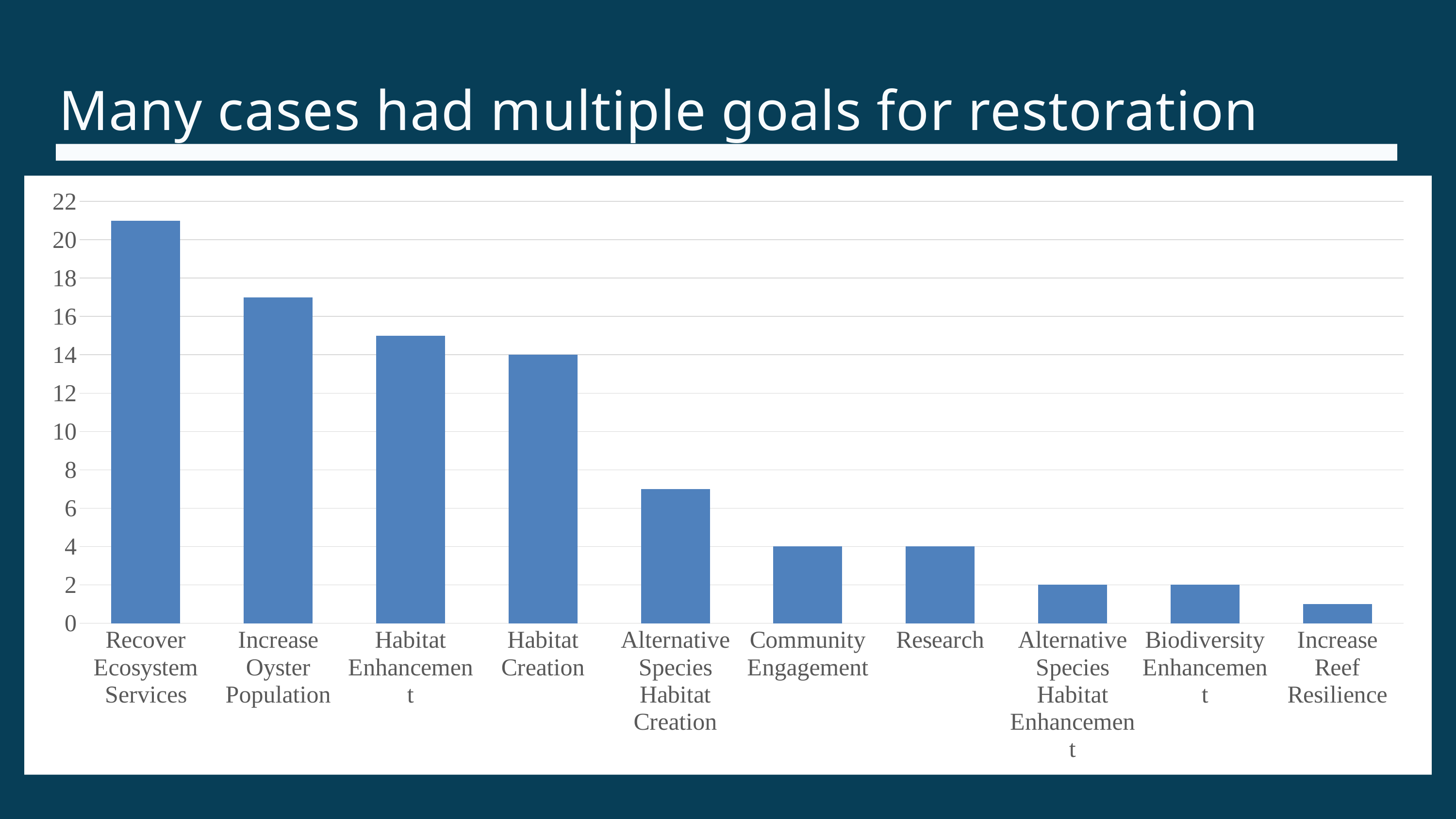
Which is larger, the value for Increase Oyster Population or the value for Habitat Creation? Increase Oyster Population How many restoration goal categories are plotted in the chart? 10 What is the value for Biodiversity Enhancement? 2 Is the value for Recover Ecosystem Services greater or less than 20? greater Do the values rise or fall moving from left to right along the x axis? fall Is the value for Increase Oyster Population greater or less than 18? less Which restoration goal has the lowest number of cases? Increase Reef Resilience What type of chart is shown on the slide? bar chart What is the value for Community Engagement? 4 What is the difference between the values for Habitat Creation and Research? 10 What is the value for Habitat Creation? 14 Which restoration goal has the highest number of cases? Recover Ecosystem Services